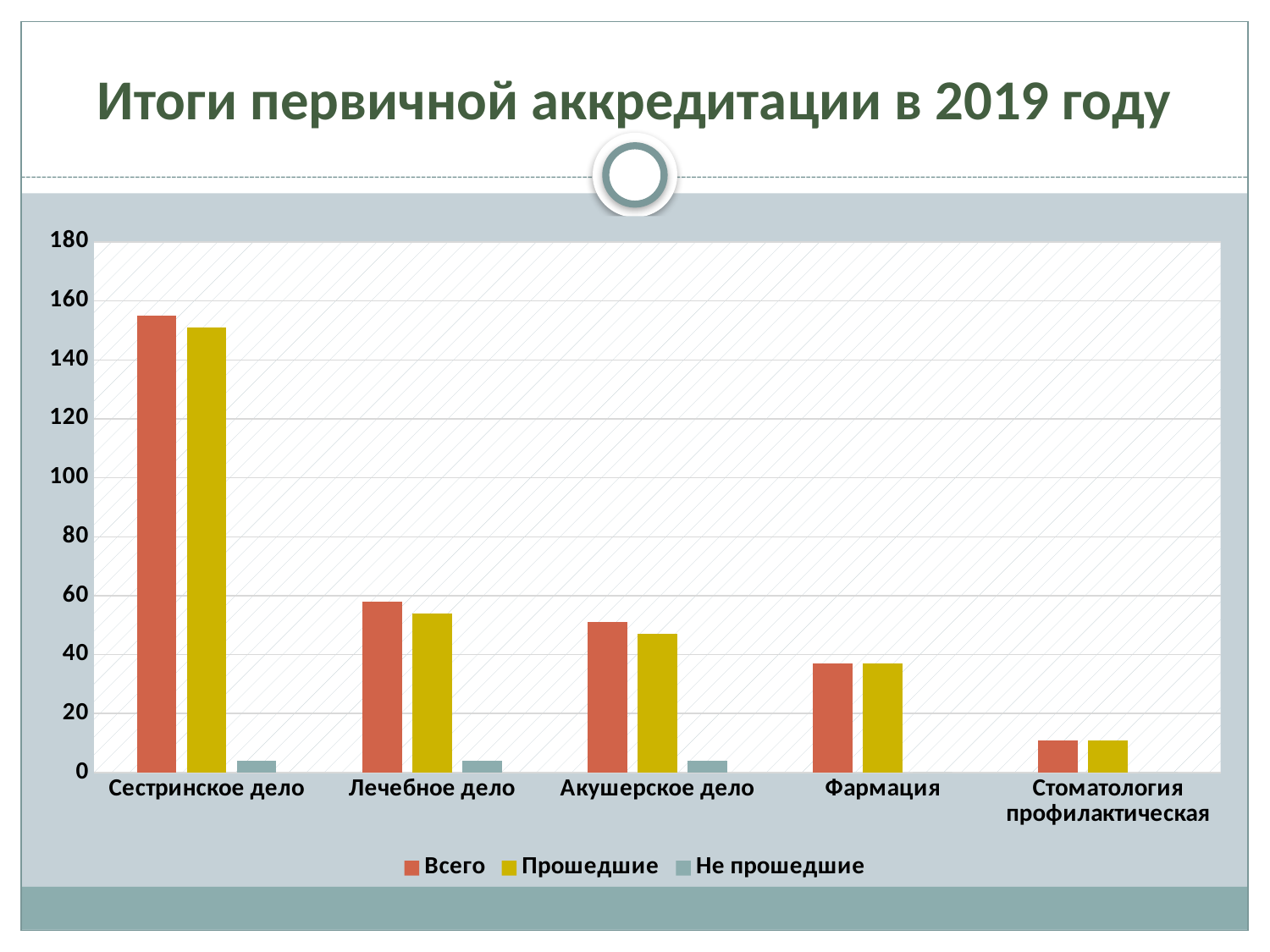
Do the Всего values rise or fall from left to right along the x axis? fall How many categories are shown on the x axis? 5 Is the value for Всего in Стоматология профилактическая greater or less than 20? less Which category has the highest value for Всего? Сестринское дело Is the value for Прошедшие in Акушерское дело greater or less than 60? less Is the value for Всего in Фармация greater or less than 20? greater What kind of chart is shown on the slide? bar chart How many series does the legend list? 3 Which category has the lowest value for Всего? Стоматология профилактическая Which is larger, the Всего value for Лечебное дело or for Акушерское дело? Лечебное дело What is the title of the chart? Итоги первичной аккредитации в 2019 году